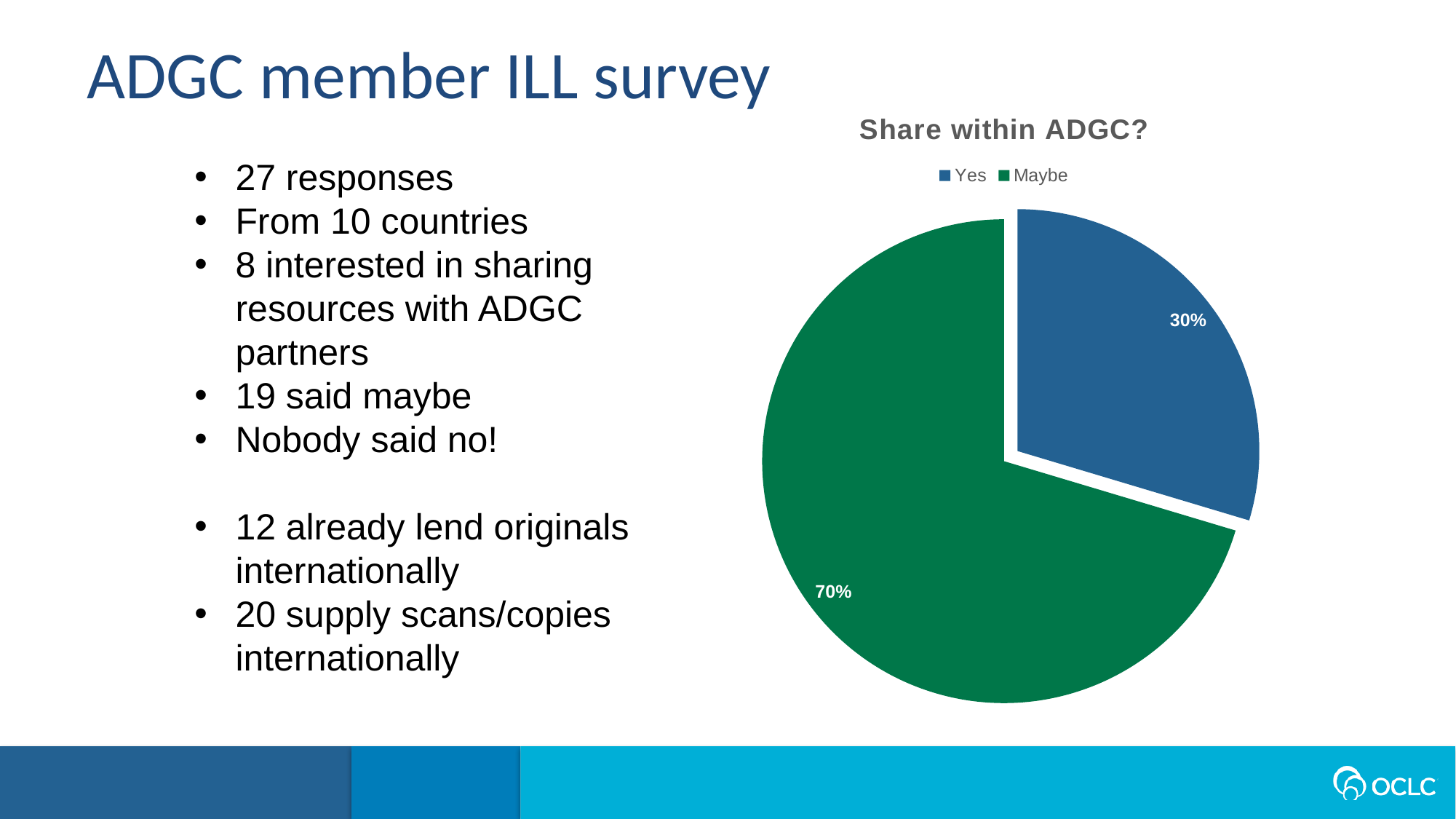
What share of the pie does the Maybe slice represent? 70% How many slices does the pie chart have? 2 What kind of chart is shown on the slide? pie chart What is the difference in percentage points between the Maybe slice and the Yes slice? 40 percentage points What is the title of the chart? Share within ADGC? Which slice of the pie is the largest? Maybe How many entries does the legend list? 2 What share of the pie does the Yes slice represent? 30% Which is larger, the Yes slice or the Maybe slice? Maybe What colour is the Maybe slice? green Which slice of the pie is the smallest? Yes